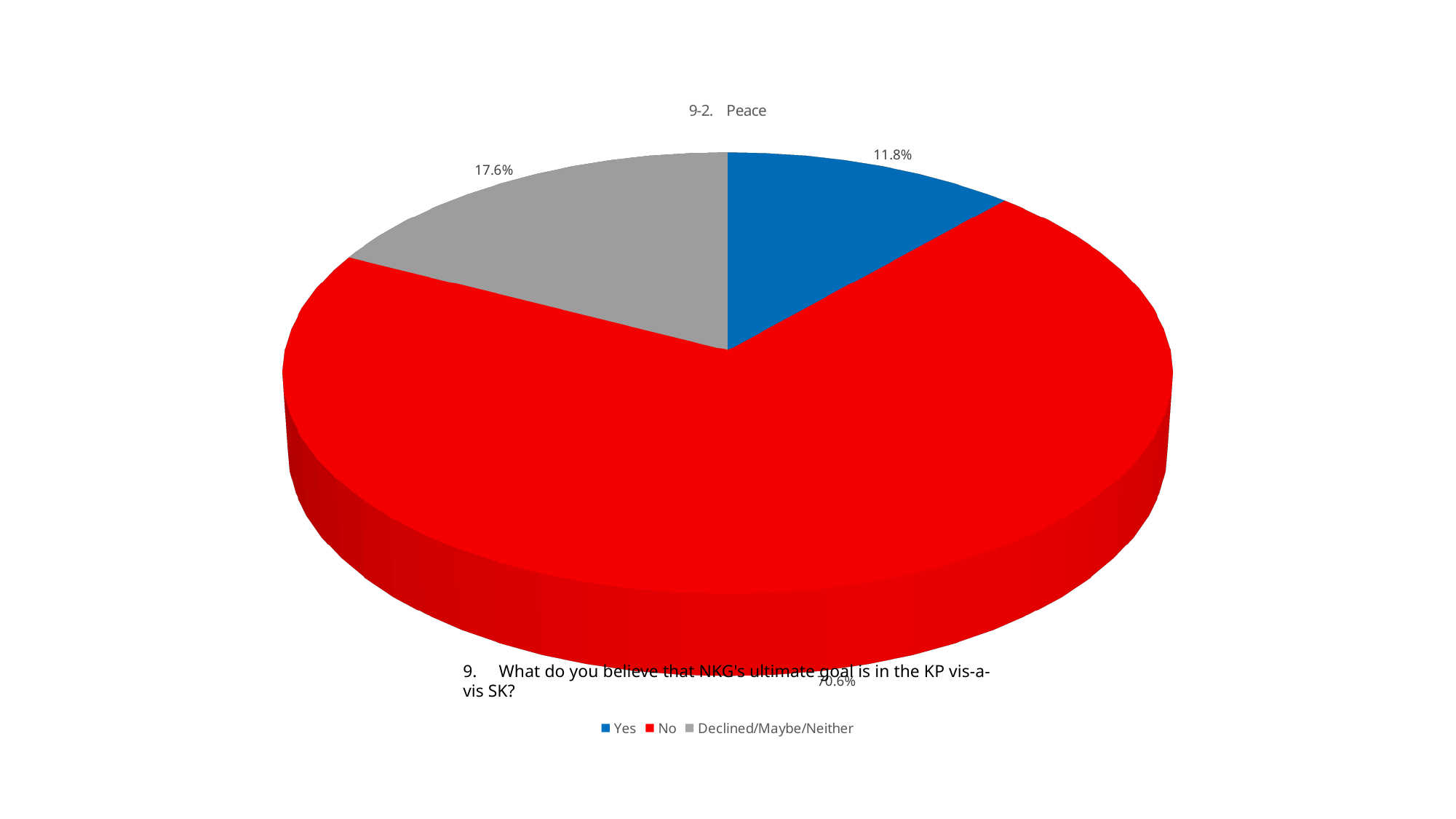
What percentage of the pie is the 'Yes' slice? 11.8% Which is larger, the 'Yes' slice or the 'Declined/Maybe/Neither' slice? Declined/Maybe/Neither Which category has the smallest share of the pie? Yes How many categories does the legend list? 3 What is the title of the chart? 9-2. Peace What is the difference in percentage points between the 'No' slice and the 'Declined/Maybe/Neither' slice? 53.0% What percentage of the pie is the 'No' slice? 70.6% What is the difference in percentage points between the 'Declined/Maybe/Neither' slice and the 'Yes' slice? 5.8% Which category has the largest share of the pie? No What percentage of the pie is the 'Declined/Maybe/Neither' slice? 17.6% What type of chart is shown on the slide? Pie chart What colour is the 'No' slice? Red